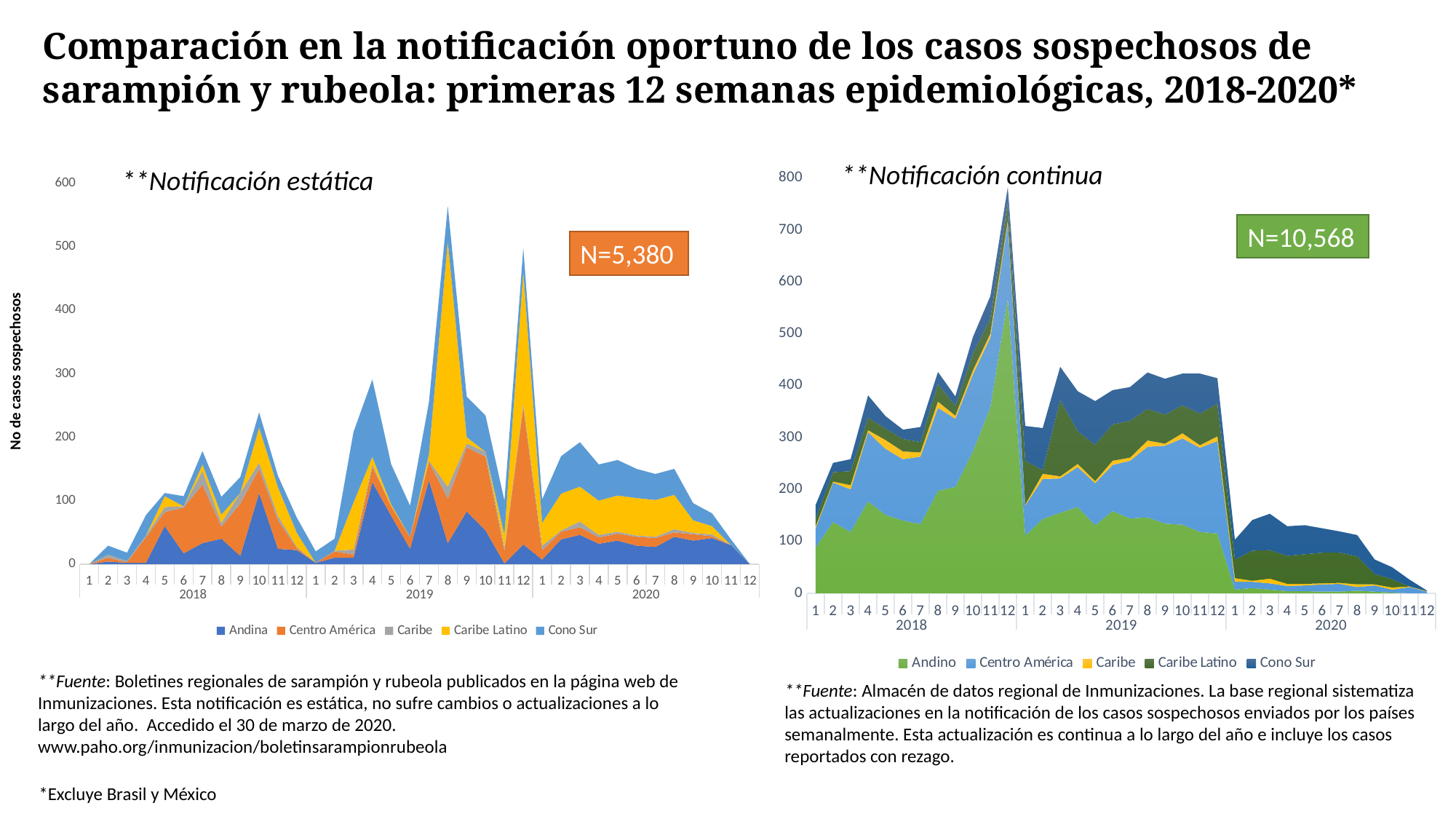
What kind of chart is the left chart titled "Notificación estática"? stacked area chart What is the N value shown on the right chart ("Notificación continua")? N=10,568 In the right chart ("Notificación continua"), is the total value at week 12 of 2018 greater or less than 700? greater What is the N value shown on the left chart ("Notificación estática")? N=5,380 In the left chart ("Notificación estática"), in which year and week does the total reach its highest peak? Week 8 of 2019 In the left chart ("Notificación estática"), is the total value at week 8 of 2019 greater or less than 500? greater What is the difference between the N values of the two charts (10,568 and 5,380)? 5,188 How many series does the legend of the left chart ("Notificación estática") list? 5 Which chart has the larger N value, "Notificación estática" or "Notificación continua"? Notificación continua How many years are shown along the x axis of the right chart ("Notificación continua")? 3 How many series does the legend of the right chart ("Notificación continua") list? 5 In the right chart ("Notificación continua"), in which year and week does the total reach its highest peak? Week 12 of 2018